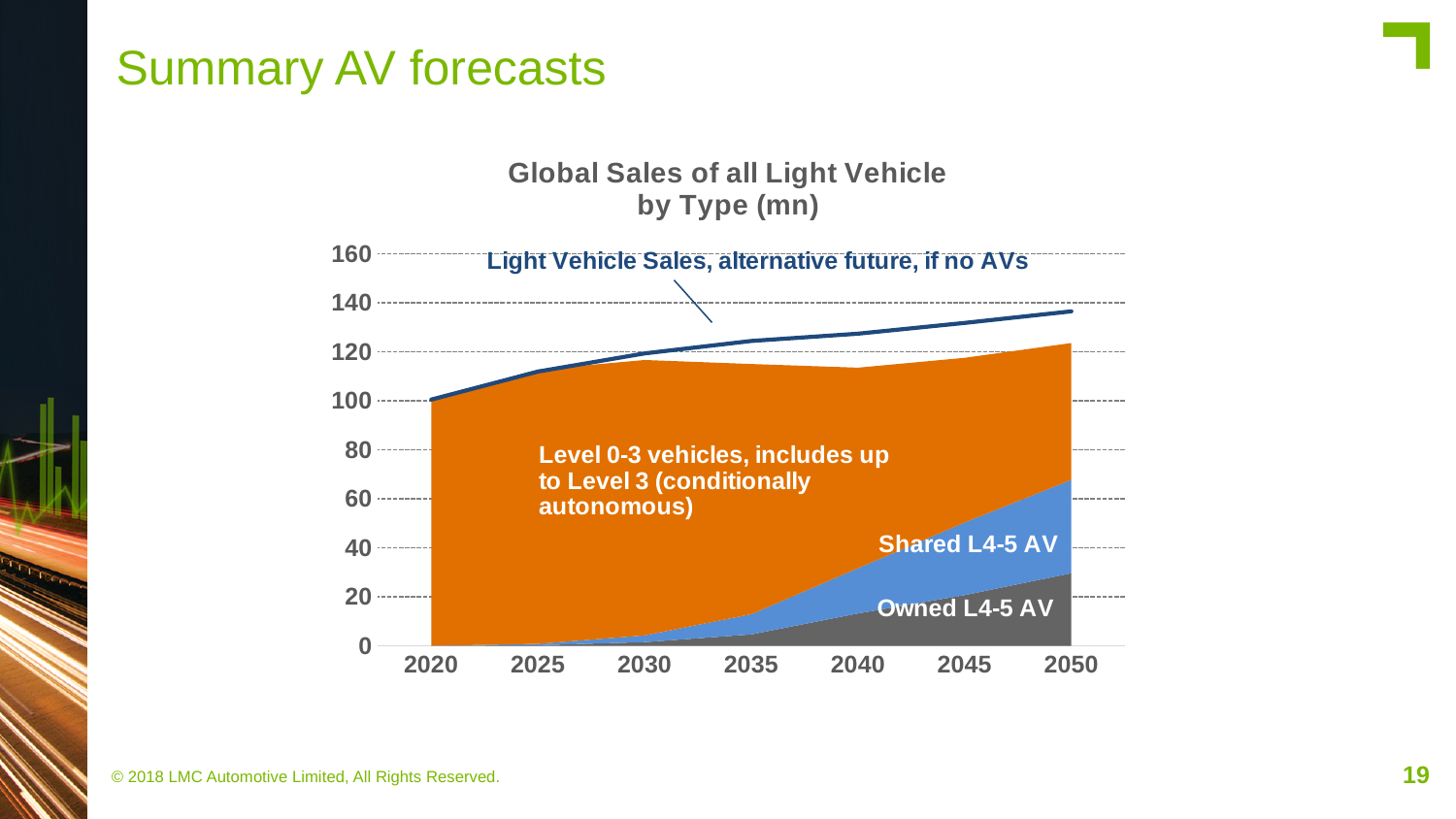
Does the 'Light Vehicle Sales, alternative future, if no AVs' line rise or fall from 2020 to 2050? rise What is the title of the chart? Global Sales of all Light Vehicle by Type (mn) Is the value of the 'Light Vehicle Sales, alternative future, if no AVs' line in 2050 greater or less than 140? less In 2050, which is larger: the Level 0-3 vehicles segment or the Owned L4-5 AV segment? Level 0-3 vehicles How many vehicle types are shown as stacked areas in the chart? 3 Is the value for Owned L4-5 AV in 2050 greater or less than 20? greater What kind of chart is shown on the slide? Area and line chart Is the value of the 'Light Vehicle Sales, alternative future, if no AVs' line in 2050 greater or less than 120? greater How many years are labelled on the x axis? 7 What does the dark blue line on the chart represent? Light Vehicle Sales, alternative future, if no AVs